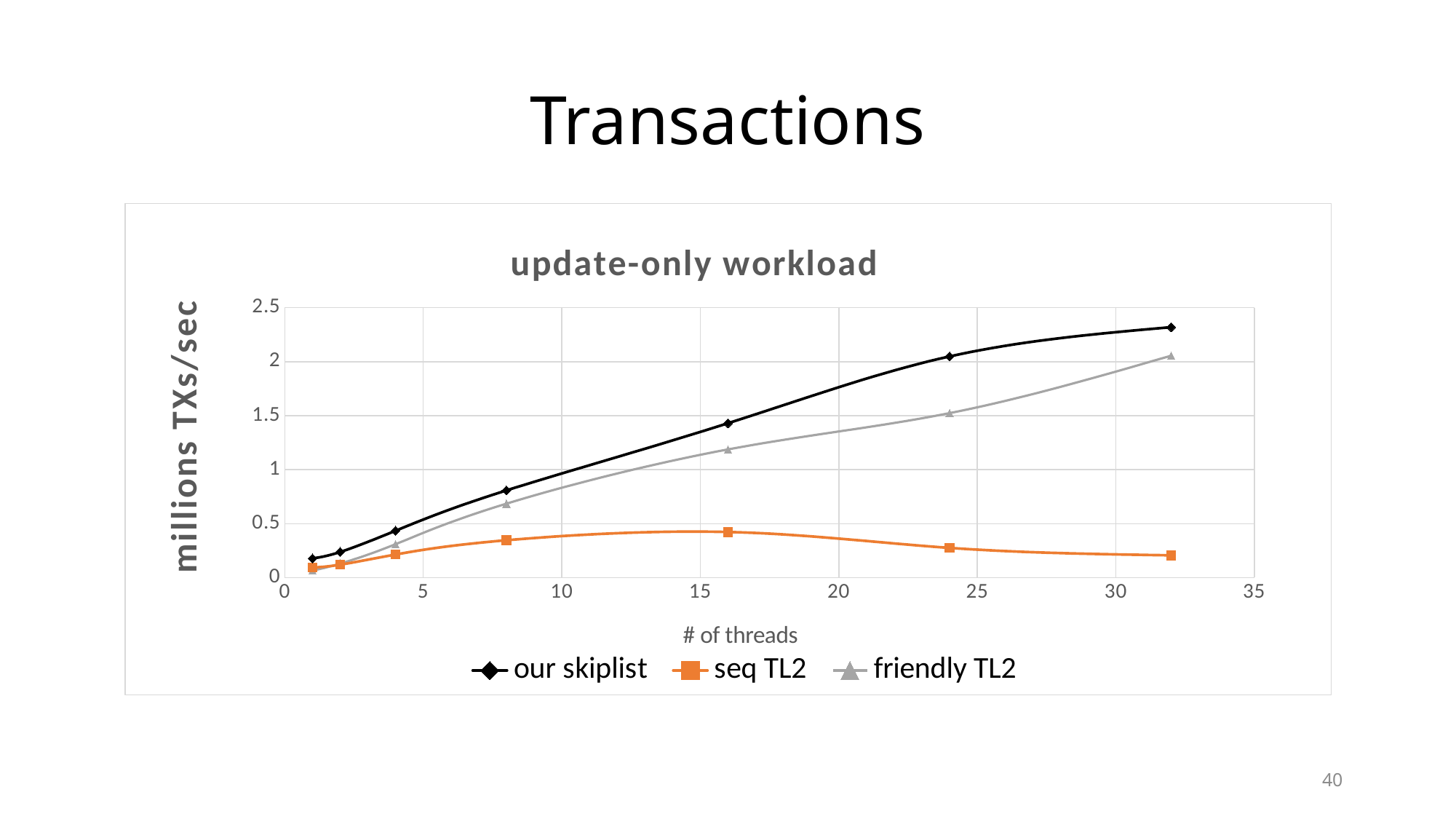
Is the value for 'friendly TL2' at 16 threads greater or less than 1? greater How many data points are plotted for the 'our skiplist' series? 7 What is the title of the chart? update-only workload How many series does the legend list? 3 What kind of chart is shown on the slide? line chart Which series has the lowest value at 32 threads? seq TL2 Is the value for 'our skiplist' at 8 threads greater or less than 1? less Is the value for 'our skiplist' at 32 threads greater or less than 2? greater At 32 threads, which is larger: 'our skiplist' or 'friendly TL2'? our skiplist Which series has the highest value at 32 threads? our skiplist Does the 'our skiplist' series rise or fall as the number of threads increases? rises